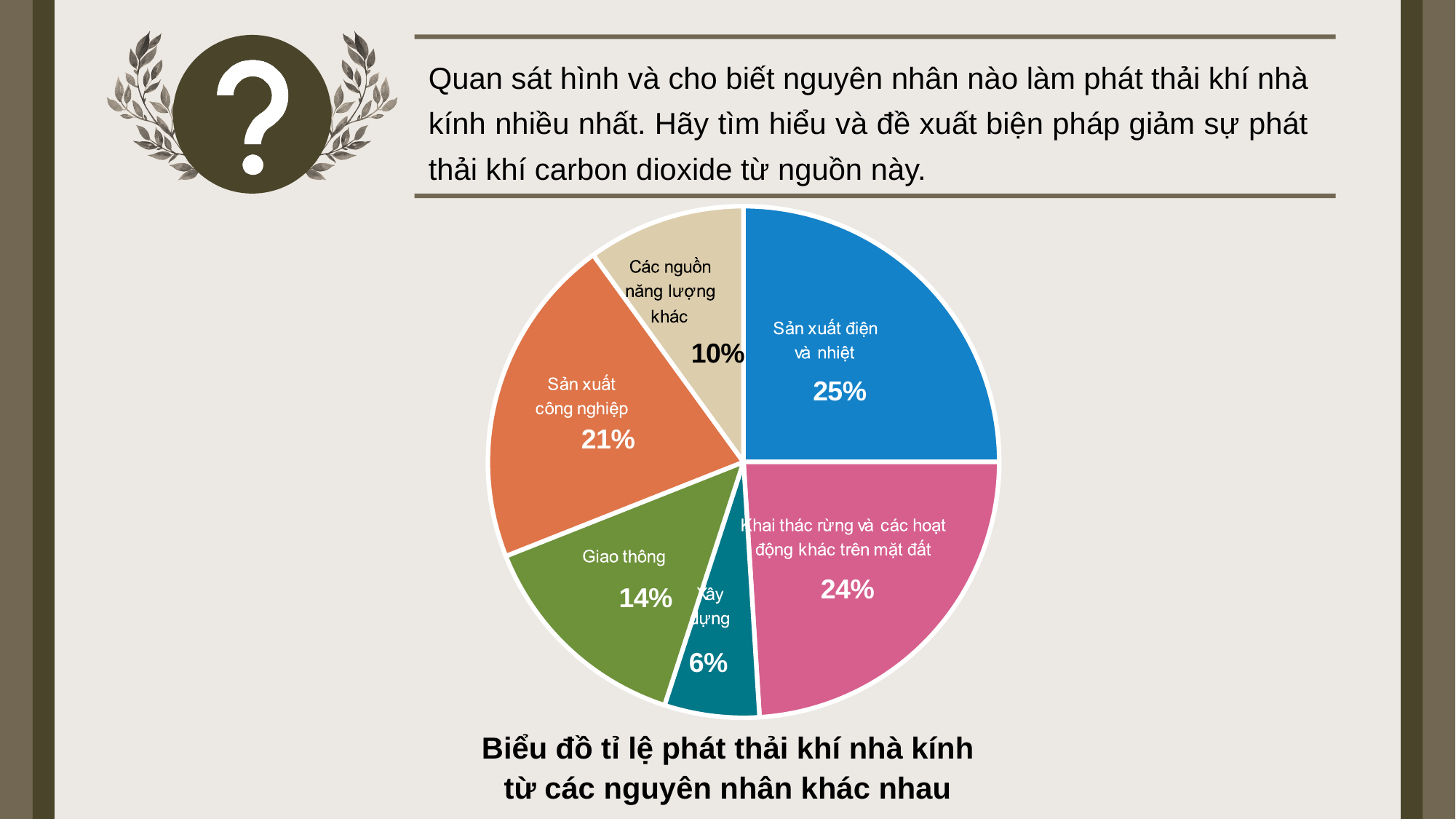
Which category has the smallest share of the pie? Xây dựng What is the title of the chart? Biểu đồ tỉ lệ phát thải khí nhà kính từ các nguyên nhân khác nhau What percentage does the 'Xây dựng' slice represent? 6% What percentage does the 'Các nguồn năng lượng khác' slice represent? 10% Which is larger: 'Khai thác rừng và các hoạt động khác trên mặt đất' or 'Sản xuất công nghiệp'? Khai thác rừng và các hoạt động khác trên mặt đất What percentage does the 'Sản xuất điện và nhiệt' slice represent? 25% What colour is the 'Giao thông' slice? Green What is the difference in percentage points between 'Sản xuất công nghiệp' and 'Giao thông'? 7 How many slices does the pie chart have? 6 What type of chart is shown on the slide? Pie chart What percentage does the 'Giao thông' slice represent? 14% Which category has the largest share of the pie? Sản xuất điện và nhiệt